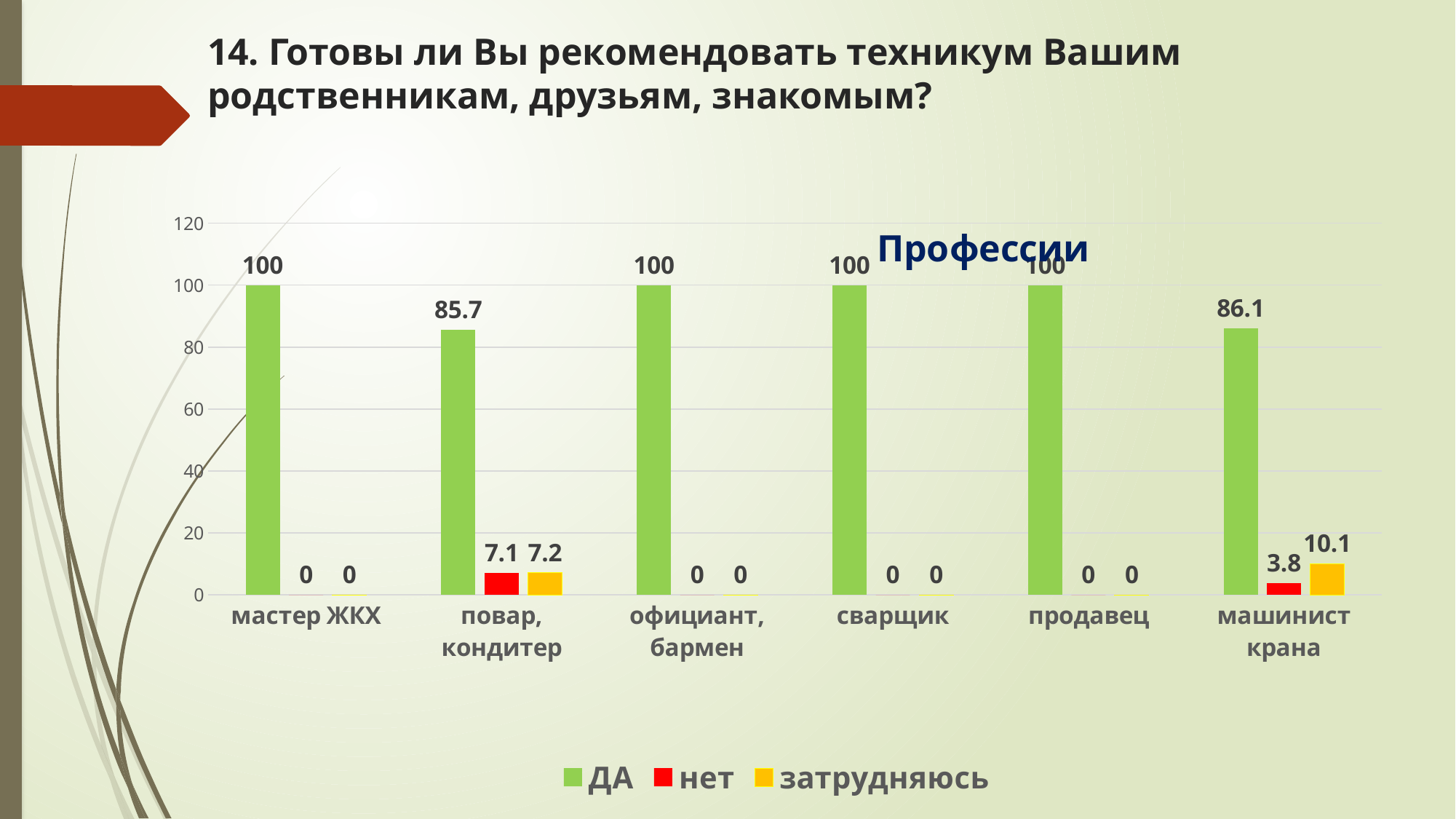
How many series does the legend list? 3 What is the value of the ДА series for машинист крана? 86.1 What is the value of the ДА series for повар, кондитер? 85.7 What kind of chart is shown on the slide? bar chart What is the title shown inside the chart area? Профессии What is the value of the затрудняюсь series for машинист крана? 10.1 What is the value of the нет series for повар, кондитер? 7.1 How many categories are shown on the x axis? 6 Which category has the lowest value in the ДА series? повар, кондитер Which is larger: the нет value for повар, кондитер or the нет value for машинист крана? повар, кондитер What is the difference between the ДА values for мастер ЖКХ and повар, кондитер? 14.3 Which category has the highest value in the затрудняюсь series? машинист крана